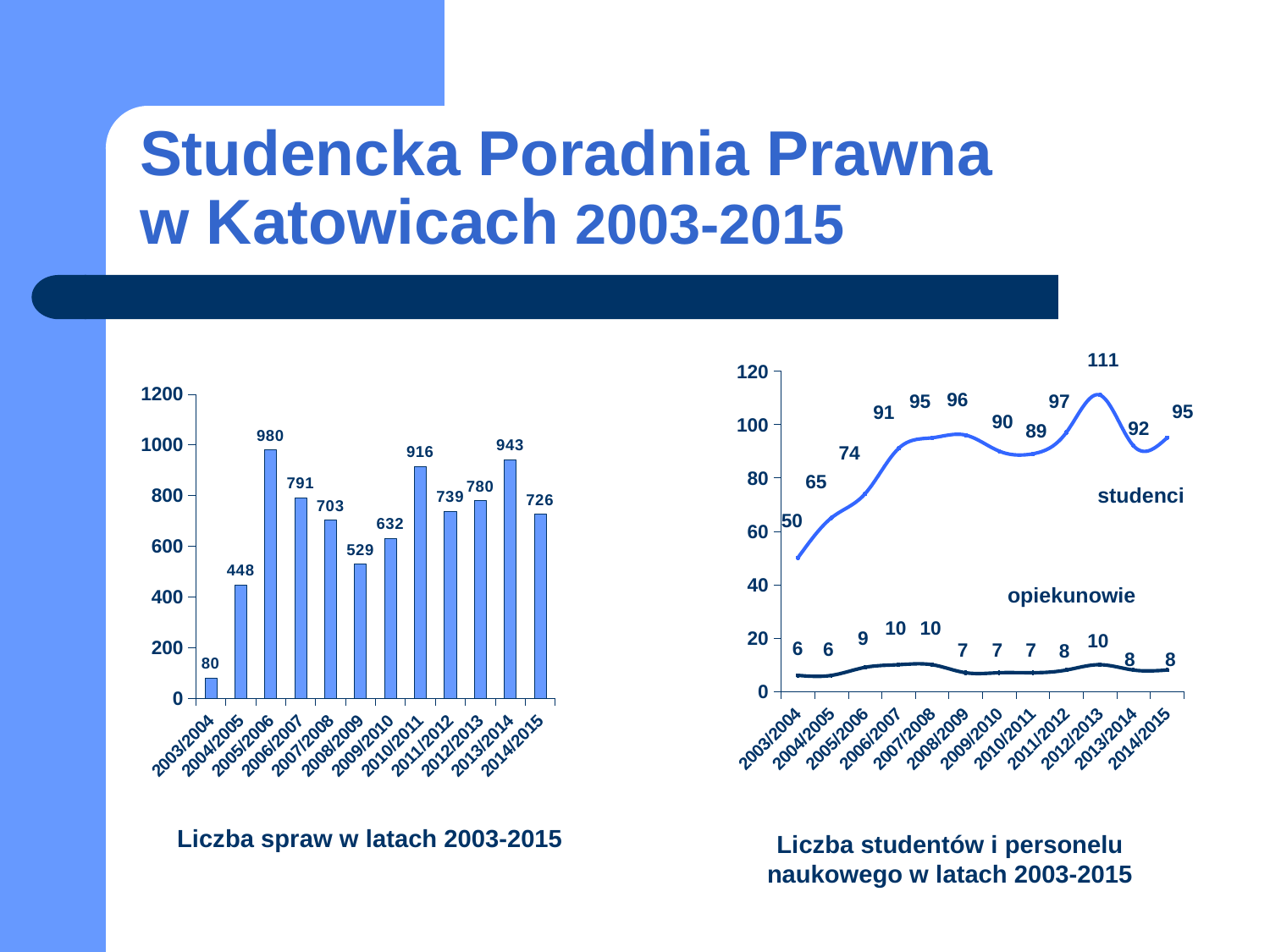
In the right chart (Liczba studentów i personelu naukowego), what is the value for studenci in 2012/2013? 111 In the left chart (Liczba spraw w latach 2003-2015), how many years are shown on the x axis? 12 In the right chart (Liczba studentów i personelu naukowego), what is the value for opiekunowie in 2005/2006? 9 What type of chart is the left chart (Liczba spraw w latach 2003-2015)? Bar chart What type of chart is the right chart (Liczba studentów i personelu naukowego)? Line chart In the right chart (Liczba studentów i personelu naukowego), in which year is the studenci value lowest? 2003/2004 In the left chart (Liczba spraw w latach 2003-2015), which is larger, the value for 2010/2011 or the value for 2012/2013? 2010/2011 In the left chart (Liczba spraw w latach 2003-2015), what is the value for 2005/2006? 980 In the left chart (Liczba spraw w latach 2003-2015), what is the difference between the values for 2013/2014 and 2014/2015? 217 In the left chart (Liczba spraw w latach 2003-2015), which year has the highest value? 2005/2006 In the left chart (Liczba spraw w latach 2003-2015), which year has the lowest number of cases? 2003/2004 In the right chart (Liczba studentów i personelu naukowego), what is the difference between studenci and opiekunowie in 2014/2015? 87